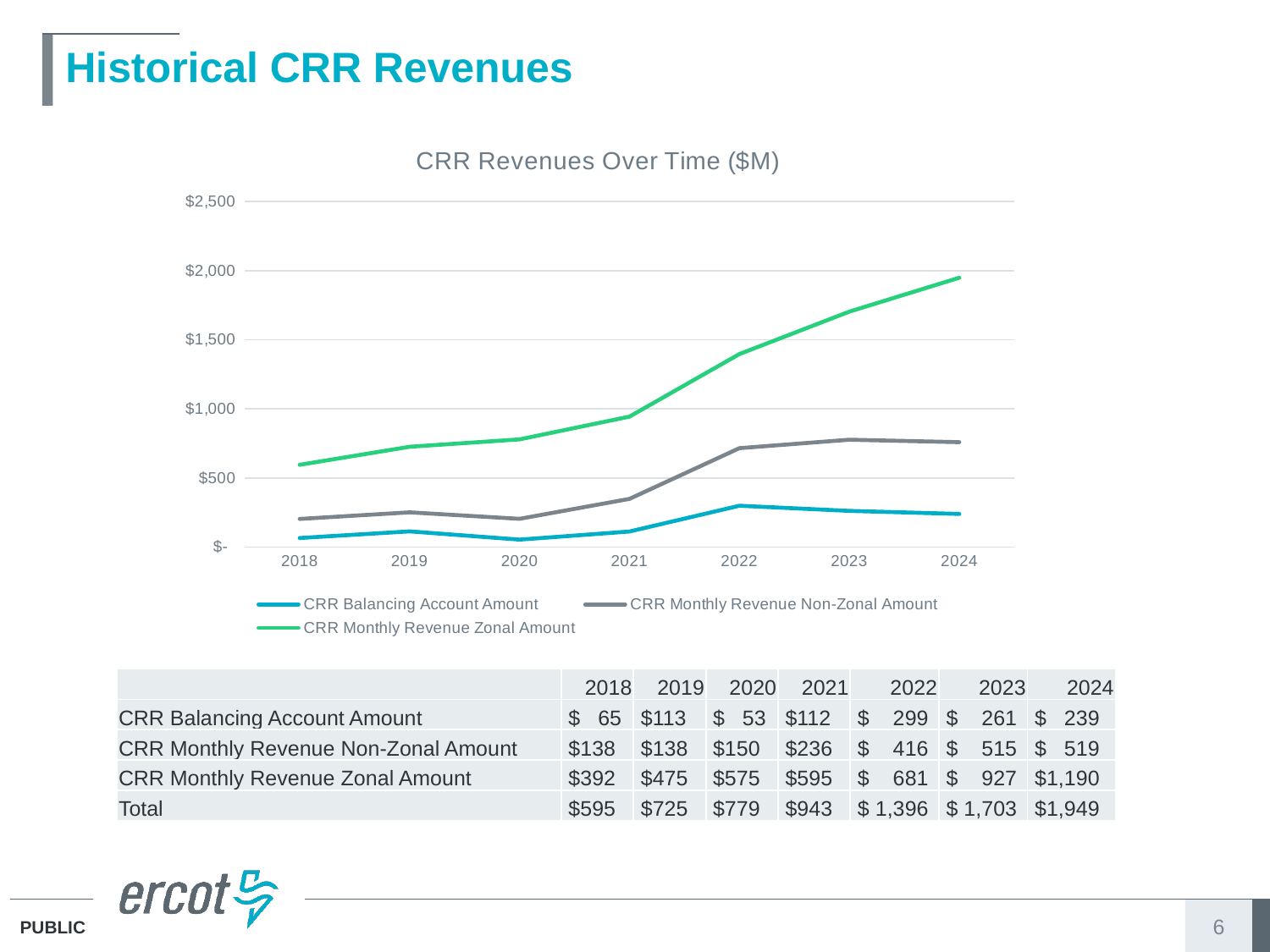
According to the table, what is the CRR Balancing Account Amount for 2020? $53 What is the difference between the CRR Monthly Revenue Non-Zonal Amount in 2023 and in 2022? $99 What is the title of the chart? CRR Revenues Over Time ($M) According to the table, what is the Total for 2022? $1,396 In which year is the Total the highest? 2024 What kind of chart is shown on the slide? line chart According to the table, what is the CRR Monthly Revenue Zonal Amount for 2024? $1,190 Which is larger, the CRR Monthly Revenue Zonal Amount in 2021 or the CRR Monthly Revenue Non-Zonal Amount in 2024? CRR Monthly Revenue Zonal Amount in 2021 How many years are shown on the x axis of the chart? 7 In which year is the CRR Balancing Account Amount the lowest? 2020 Does the Total rise or fall from 2018 to 2024? rise How many series does the chart legend list? 3